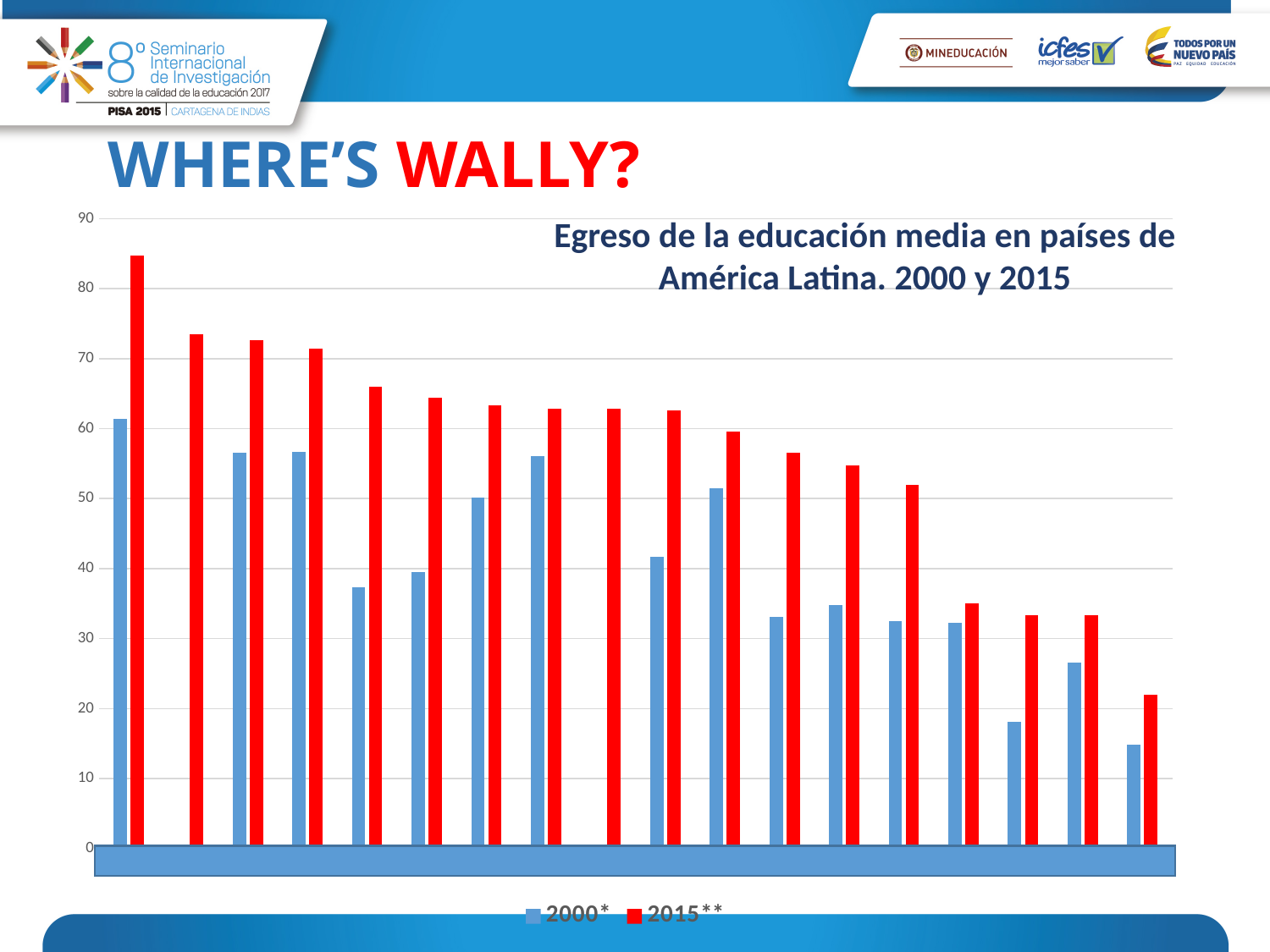
Is the 2015** value for the leftmost category greater or less than 80? greater Do the 2015** values generally rise or fall moving from left to right along the x axis? Fall Which category has the highest 2015** value? The leftmost category In the leftmost category, which series has the larger value, 2000* or 2015**? 2015** In the rightmost category, which series has the larger value, 2000* or 2015**? 2015** Is the 2000* value for the leftmost category greater or less than 60? greater Is the 2000* value for the rightmost category greater or less than 20? less What is the highest value shown on the vertical axis? 90 How many series does the chart legend list? 2 What kind of chart is shown on the slide? Bar chart What are the two series named in the chart legend? 2000* and 2015** What is the title of the chart? Egreso de la educación media en países de América Latina. 2000 y 2015